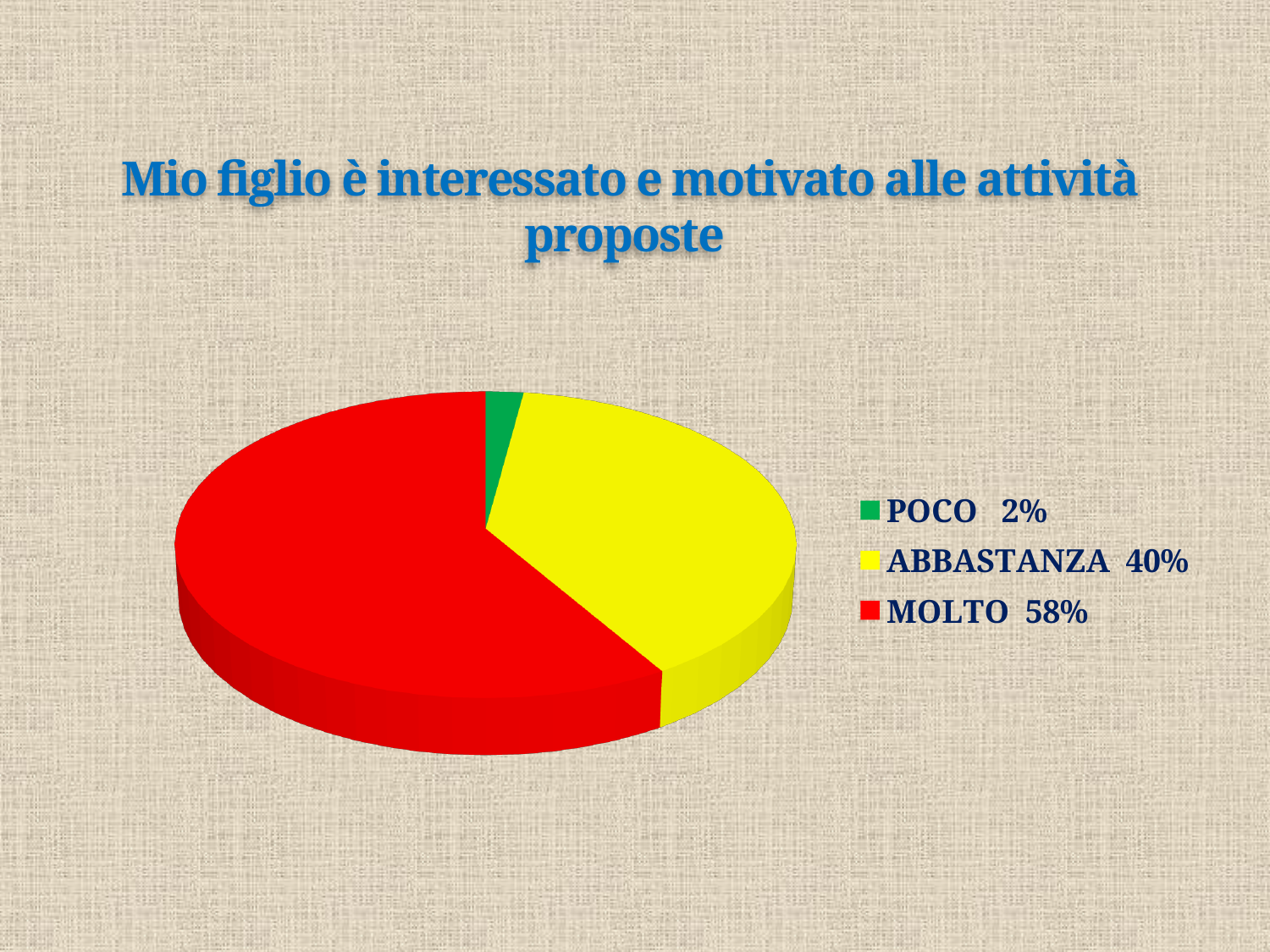
Which is larger, the share for ABBASTANZA or the share for POCO? ABBASTANZA Which category has the largest slice of the pie? MOLTO What share of the pie does POCO represent? 2% What share of the pie does MOLTO represent? 58% What colour is the slice for ABBASTANZA? Yellow Which category has the smallest slice of the pie? POCO What kind of chart is shown on the slide? Pie chart How many categories are shown in the pie chart? 3 What is the difference in percentage points between ABBASTANZA and POCO? 38% What share of the pie does ABBASTANZA represent? 40% What is the difference in percentage points between MOLTO and ABBASTANZA? 18% What is the title of the chart? Mio figlio è interessato e motivato alle attività proposte